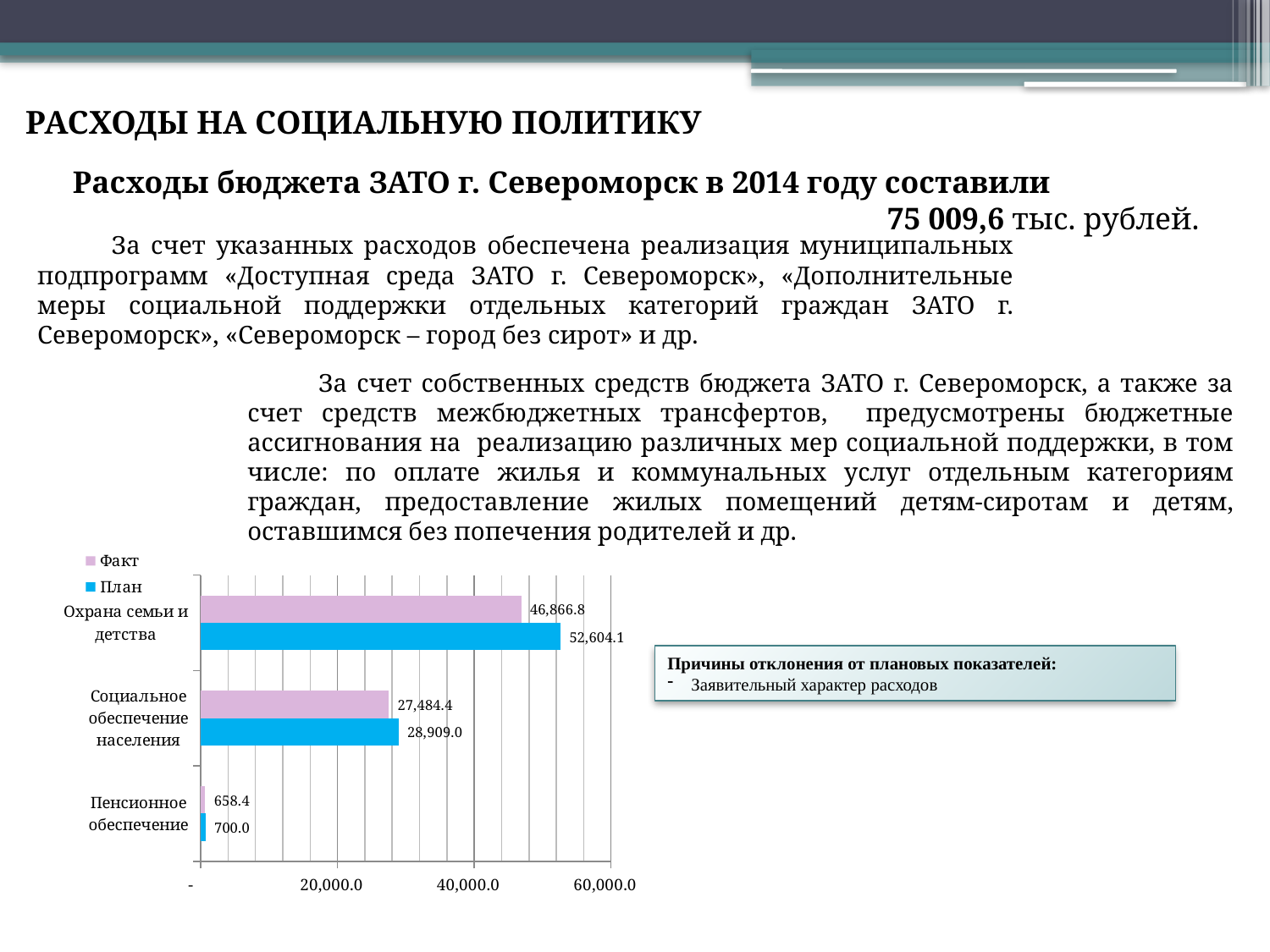
Is the Факт value for Охрана семьи и детства greater or less than 40,000.0? greater What is the План value for Пенсионное обеспечение? 700.0 What is the План value for Охрана семьи и детства? 52,604.1 Which category has the highest План value? Охрана семьи и детства How many categories are shown on the chart? 3 Which category has the lowest Факт value? Пенсионное обеспечение What is the difference between the План and Факт values for Охрана семьи и детства? 5,737.3 What kind of chart is shown on the slide? bar chart What is the Факт value for Социальное обеспечение населения? 27,484.4 How many series does the legend list? 2 What is the Факт value for Пенсионное обеспечение? 658.4 Which is larger for Социальное обеспечение населения, the План value or the Факт value? План